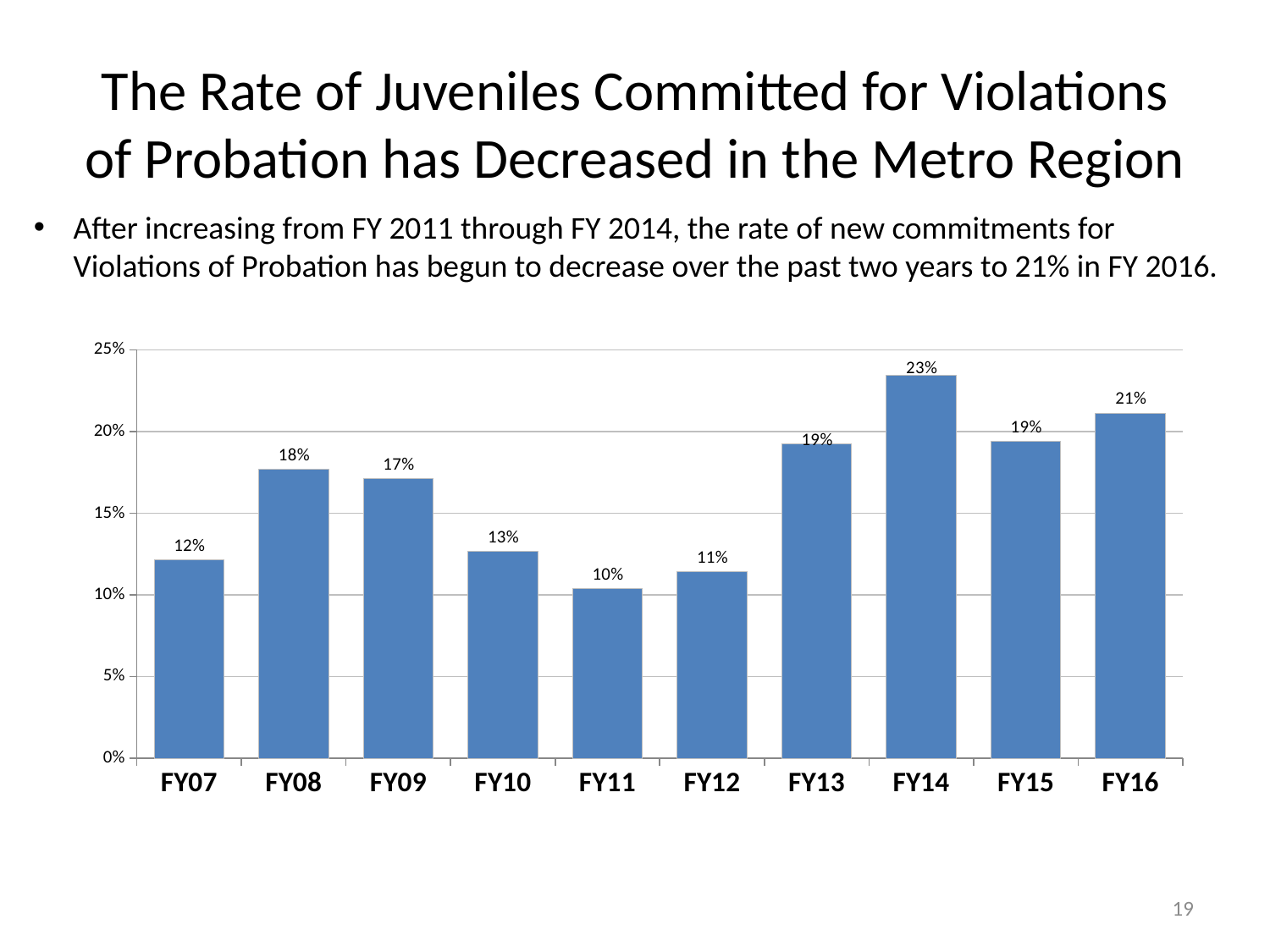
What kind of chart is shown on the slide? bar chart Which fiscal year has the highest value? FY14 Which is larger, the value for FY09 or the value for FY13? FY13 What is the value for FY16? 21% Which fiscal year has the lowest value? FY11 How many fiscal years are shown on the x axis? 10 What is the difference between the values for FY14 and FY11? 13% What is the value for FY08? 18% Do the values rise or fall from FY11 to FY14? rise Is the value for FY10 greater or less than 15%? less What is the value for FY11? 10% What is the highest value shown on the y axis? 25%